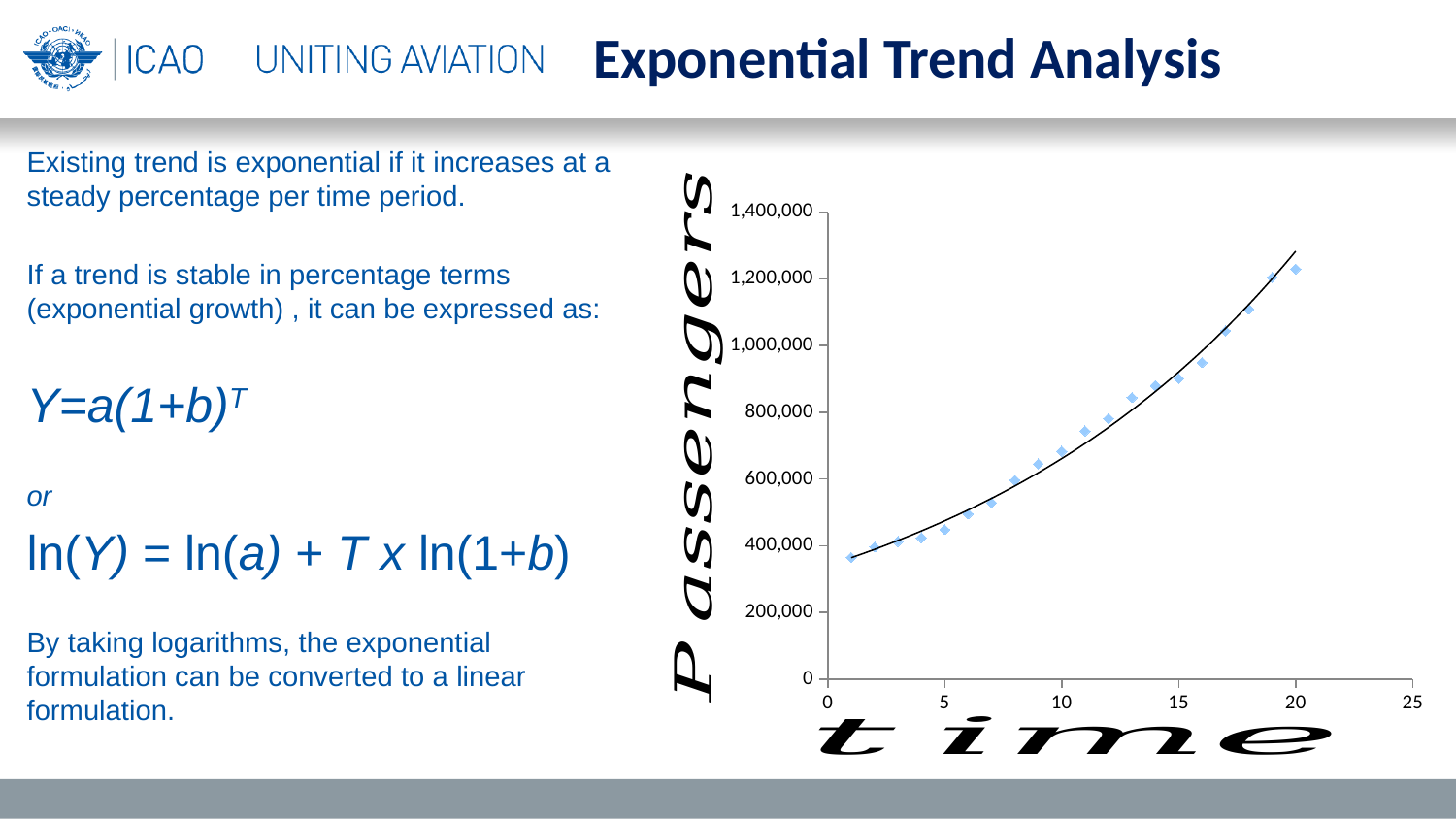
Is the passenger value at time 15 greater or less than 800,000? greater Is the passenger value at time 10 greater or less than 600,000? greater Is the passenger value at time 1 greater or less than 400,000? less What is the label of the horizontal axis of the chart? time At which time value is the plotted passenger value lowest? 1 What is the label of the vertical axis of the chart? Passengers At which time value is the plotted passenger value highest? 20 Do the plotted passenger values rise or fall as time increases? rise Which has the larger passenger value, time 5 or time 15? time 15 What kind of chart is shown on the slide? scatter chart